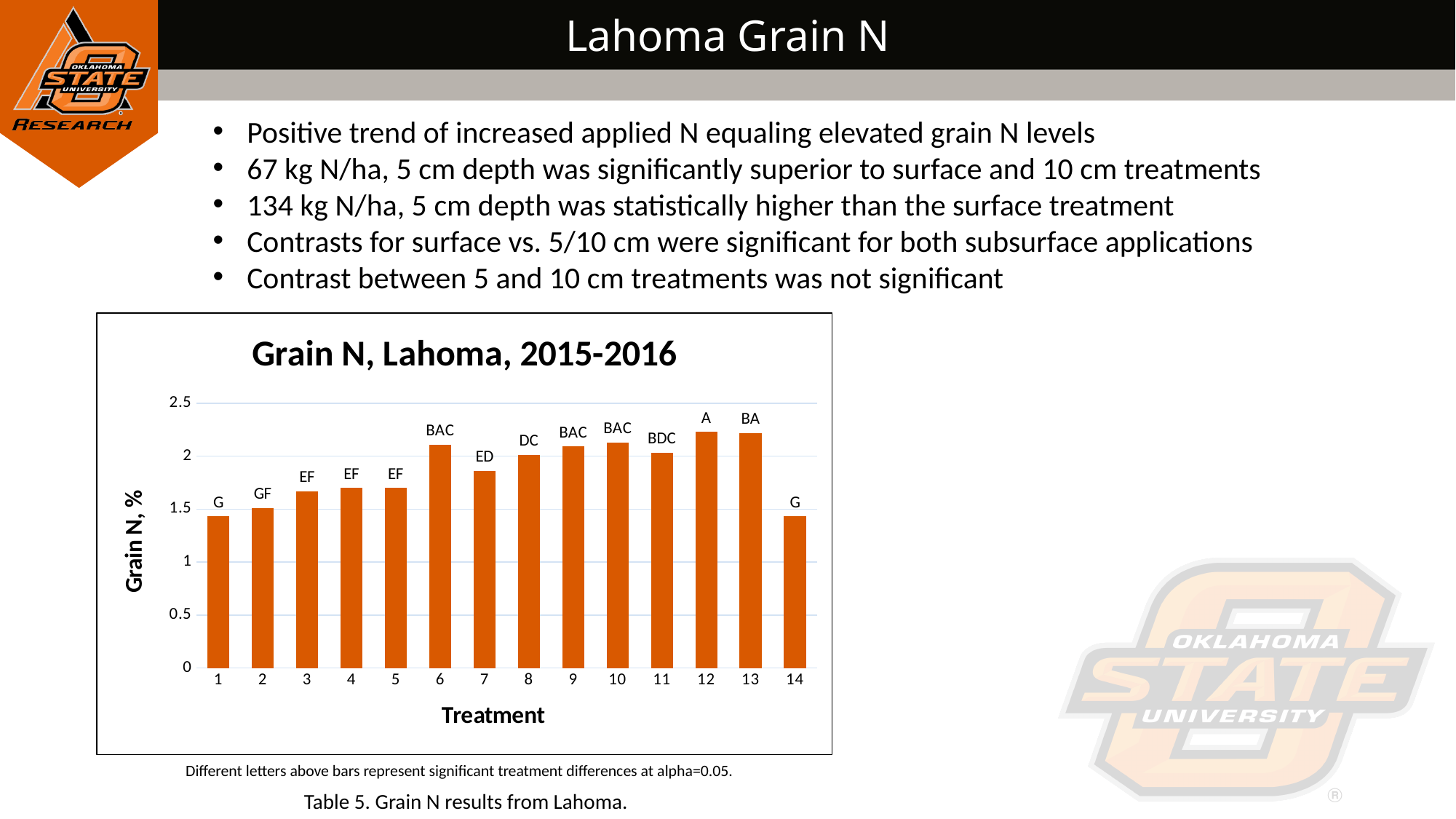
Is the value for treatment 12 greater or less than 2? greater Is the value for treatment 3 greater or less than 1.5? greater Which has the larger grain N value, treatment 12 or treatment 14? treatment 12 Is the value for treatment 1 greater or less than 1.5? less What letter label appears above the bar for treatment 12? A Do the values rise or fall from treatment 1 to treatment 6? rise What is the title of the chart? Grain N, Lahoma, 2015-2016 How many treatments are plotted on the x axis of the chart? 14 Which has the larger grain N value, treatment 6 or treatment 7? treatment 6 What kind of chart is shown on the slide? bar chart